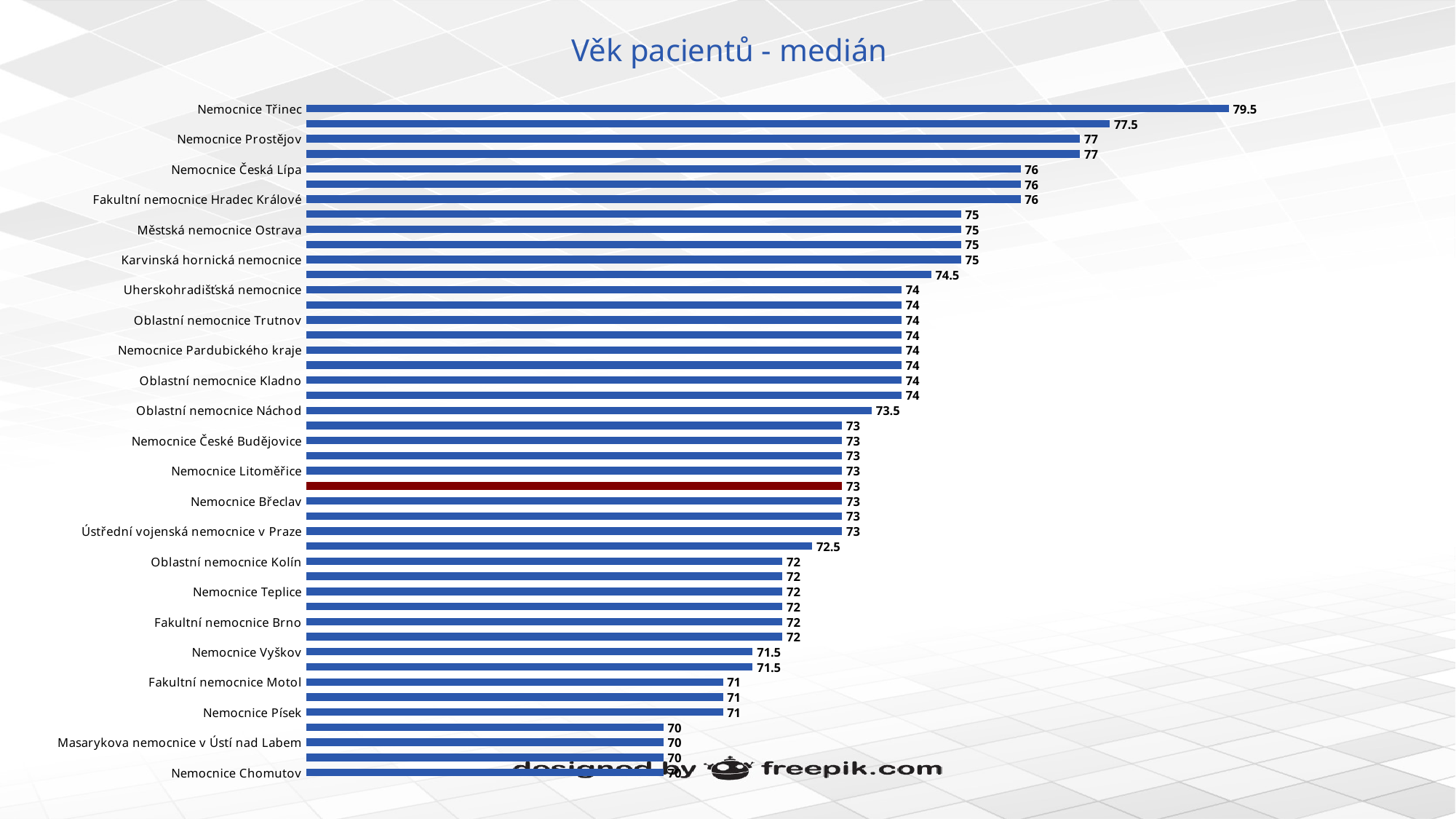
Which has a higher median patient age, Nemocnice Prostějov or Oblastní nemocnice Kolín? Nemocnice Prostějov What is the median patient age for Fakultní nemocnice Hradec Králové? 76 Which hospital has the highest median patient age? Nemocnice Třinec What is the median patient age for Masarykova nemocnice v Ústí nad Labem? 70 What is the title of the chart? Věk pacientů - medián What is the median patient age for Nemocnice Prostějov? 77 What kind of chart is shown on the slide? Bar chart What is the median patient age for Oblastní nemocnice Náchod? 73.5 What is the median patient age for Nemocnice Třinec? 79.5 What is the median patient age for Nemocnice Vyškov? 71.5 Do the values rise or fall going from the top bar to the bottom bar? Fall What is the difference between the median patient age of Nemocnice Třinec and Nemocnice Chomutov? 9.5